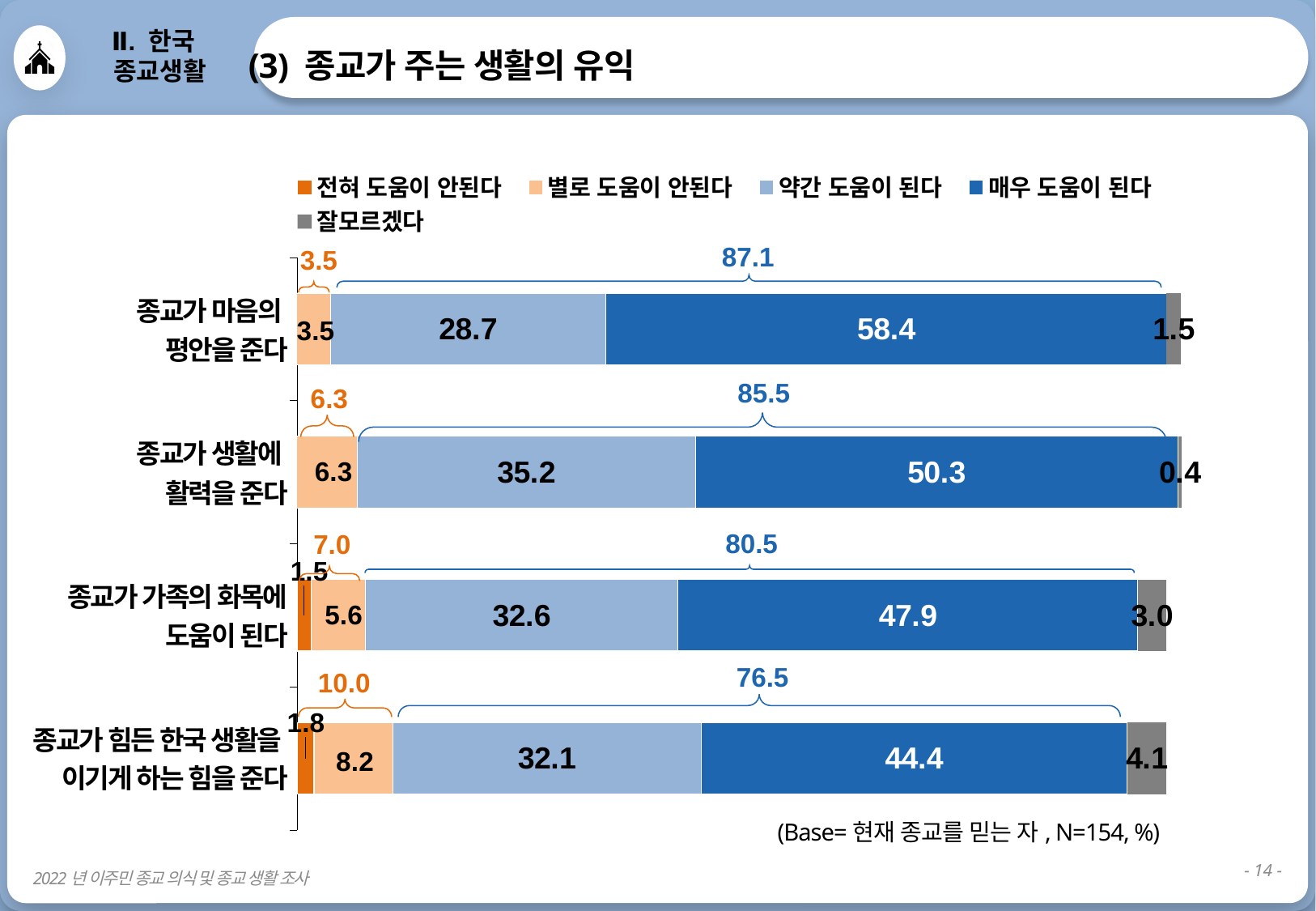
What kind of chart is shown on the slide? Stacked bar chart How many series does the legend list? 5 What is the difference between the '매우 도움이 된다' values for '종교가 생활에 활력을 준다' and '종교가 힘든 한국 생활을 이기게 하는 힘을 준다'? 5.9 What is the value of '전혀 도움이 안된다' for '종교가 가족의 화목에 도움이 된다'? 1.5 What is the value of '매우 도움이 된다' for '종교가 마음의 평안을 준다'? 58.4 What is the value of '약간 도움이 된다' for '종교가 생활에 활력을 준다'? 35.2 What is the value of '잘모르겠다' for '종교가 힘든 한국 생활을 이기게 하는 힘을 준다'? 4.1 How many categories (statements) are plotted in the chart? 4 What is the combined value of '약간 도움이 된다' and '매우 도움이 된다' shown by the bracket for '종교가 가족의 화목에 도움이 된다'? 80.5 Which category has the lowest value for '잘모르겠다'? 종교가 생활에 활력을 준다 Which category has the highest value for '매우 도움이 된다'? 종교가 마음의 평안을 준다 Which is larger: the '별로 도움이 안된다' value for '종교가 가족의 화목에 도움이 된다' or for '종교가 힘든 한국 생활을 이기게 하는 힘을 준다'? 종교가 힘든 한국 생활을 이기게 하는 힘을 준다